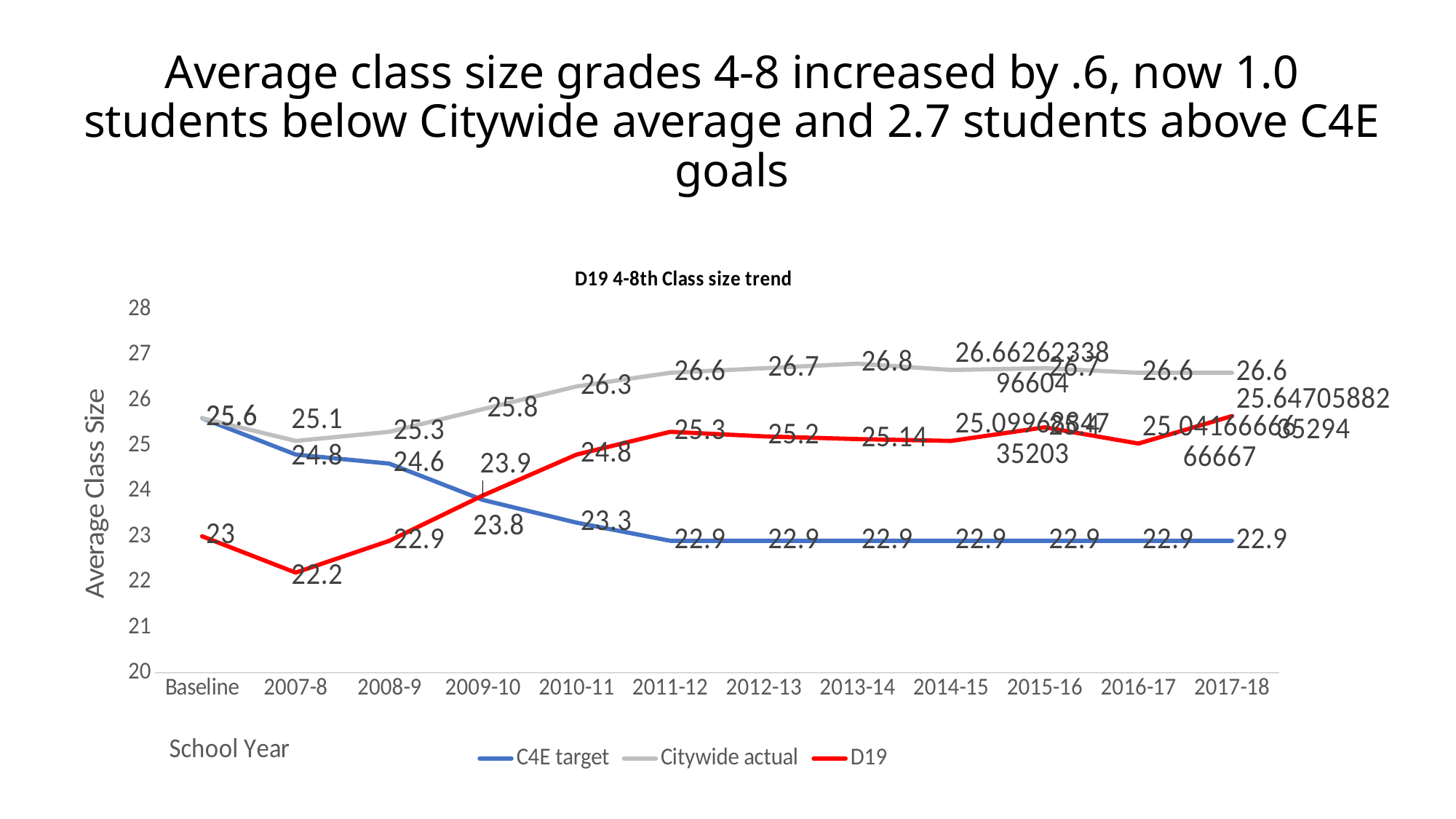
What is the D19 value for 2010-11? 24.8 In which school year is the D19 value lowest? 2007-8 What is the difference between the Citywide actual value and the C4E target value in 2013-14? 3.9 In 2011-12, which is larger: the D19 value or the C4E target value? D19 In which school year is the Citywide actual value highest? 2013-14 Does the C4E target line rise or fall from Baseline to 2011-12? fall How many series does the legend list? 3 What is the D19 value for 2007-8? 22.2 What kind of chart is shown on the slide? line chart What is the Citywide actual value for 2013-14? 26.8 What is the C4E target value for 2017-18? 22.9 How many school years (points) are shown along the x axis? 12